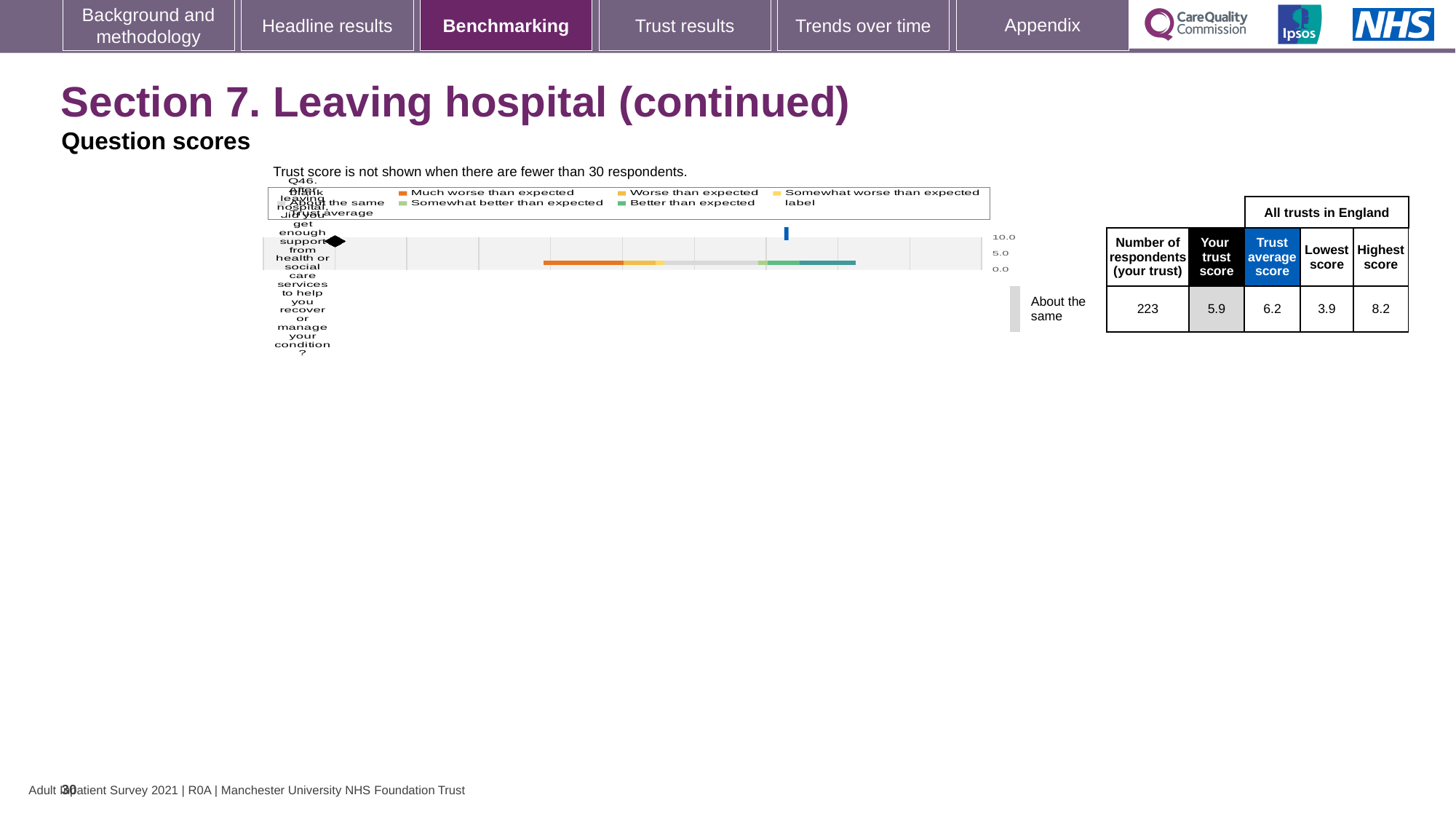
What is the trust's score for Q46 (support from health or social care services after leaving hospital)? 5.9 Is the trust's score for Q46 greater or less than 5.0 on the chart axis? greater What is the lowest score among all trusts in England for Q46? 3.9 What kind of chart is used to show the Q46 benchmarking result? bar chart Which benchmark category does the trust's Q46 score fall into? About the same How many respondents from the trust answered Q46? 223 By how much does the trust average score exceed the trust's own score for Q46? 0.3 Is the trust's score for Q46 higher or lower than the trust average score? lower What is the difference between the highest and lowest scores across all trusts in England for Q46? 4.3 What is the highest score among all trusts in England for Q46? 8.2 How many questions are plotted on the benchmarking chart on this slide? 1 What is the trust average score for Q46 across all trusts in England? 6.2